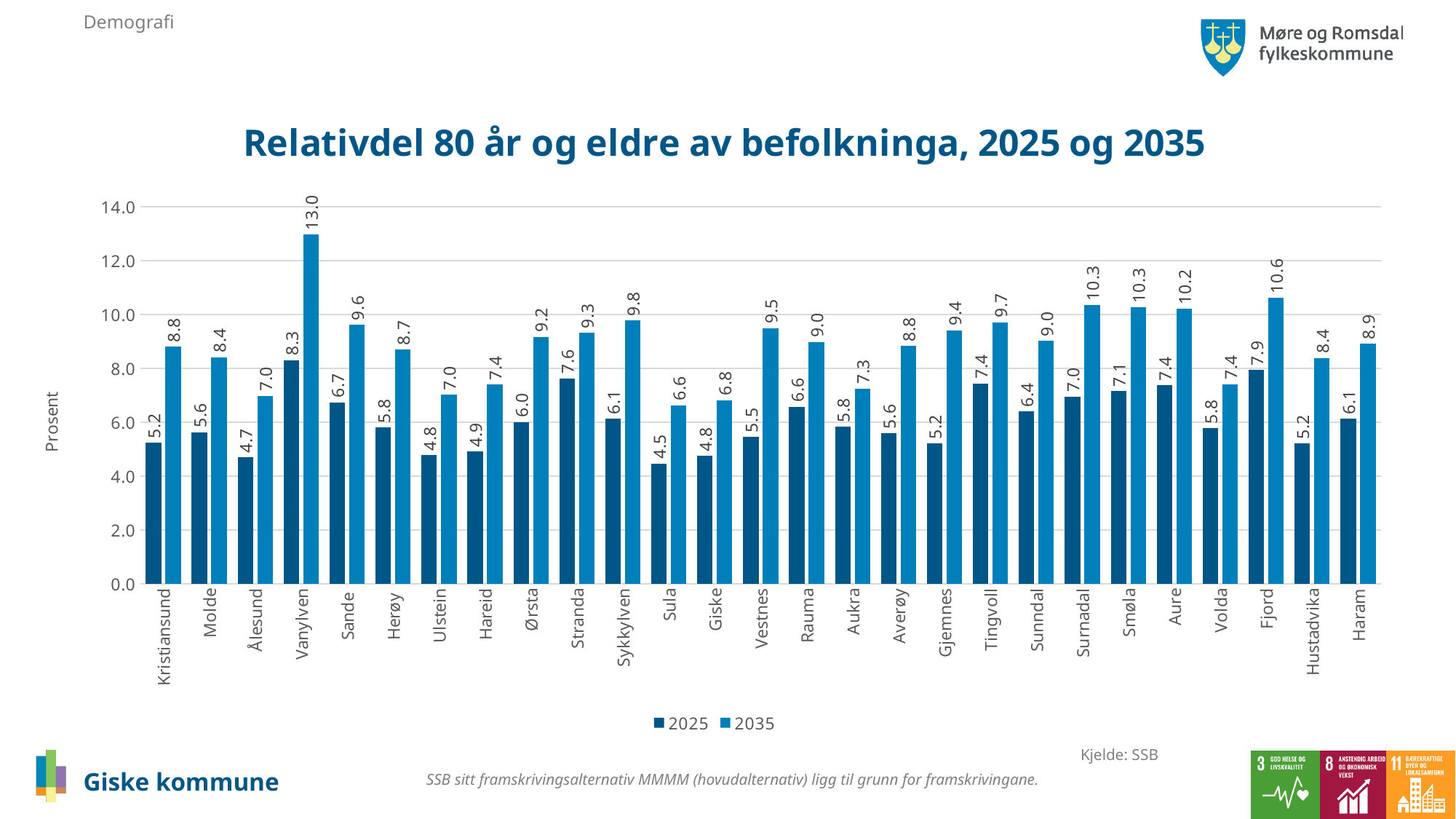
What is the difference between the 2035 values for Vanylven and Sula? 6.4 What is the 2035 value for Fjord? 10.6 What type of chart is shown? Bar chart Which municipality has the highest 2035 value? Vanylven Which is larger, the 2025 value for Fjord or the 2025 value for Stranda? Fjord What is the 2025 value for Vanylven? 8.3 Which municipality has the lowest 2025 value? Sula What is the 2035 value for Giske? 6.8 How many series does the legend list? 2 What is the difference between the 2035 and 2025 values for Giske? 2.0 Is the 2035 value for Surnadal greater or less than 10.0? greater How many municipalities are shown on the x axis? 27